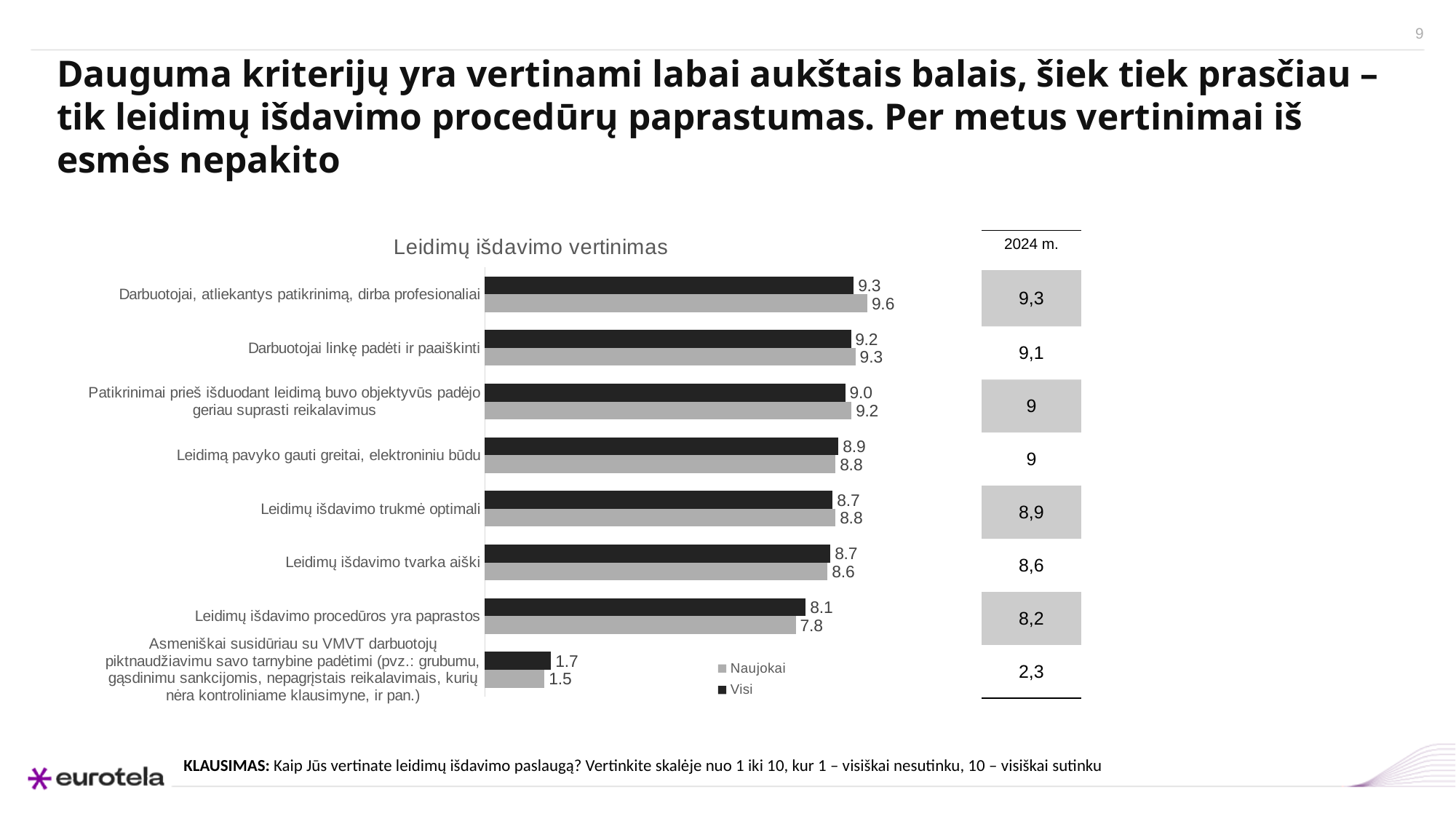
What is the Naujokai value for 'Leidimų išdavimo tvarka aiški'? 8.6 How many categories are plotted in the chart? 8 What is the difference between the Visi and Naujokai values for 'Leidimų išdavimo procedūros yra paprastos'? 0.3 Which category has the lowest Visi value? Asmeniškai susidūriau su VMVT darbuotojų piktnaudžiavimu savo tarnybine padėtimi For 'Leidimą pavyko gauti greitai, elektroniniu būdu', which series has the larger value, Visi or Naujokai? Visi What type of chart is shown on the slide? bar chart What is the title of the chart? Leidimų išdavimo vertinimas How many series does the chart legend list? 2 What is the 2024 m. value shown next to 'Leidimų išdavimo trukmė optimali'? 8,9 What is the Naujokai value for 'Darbuotojai, atliekantys patikrinimą, dirba profesionaliai'? 9.6 Which category has the highest Naujokai value? Darbuotojai, atliekantys patikrinimą, dirba profesionaliai What is the Visi value for 'Leidimų išdavimo procedūros yra paprastos'? 8.1